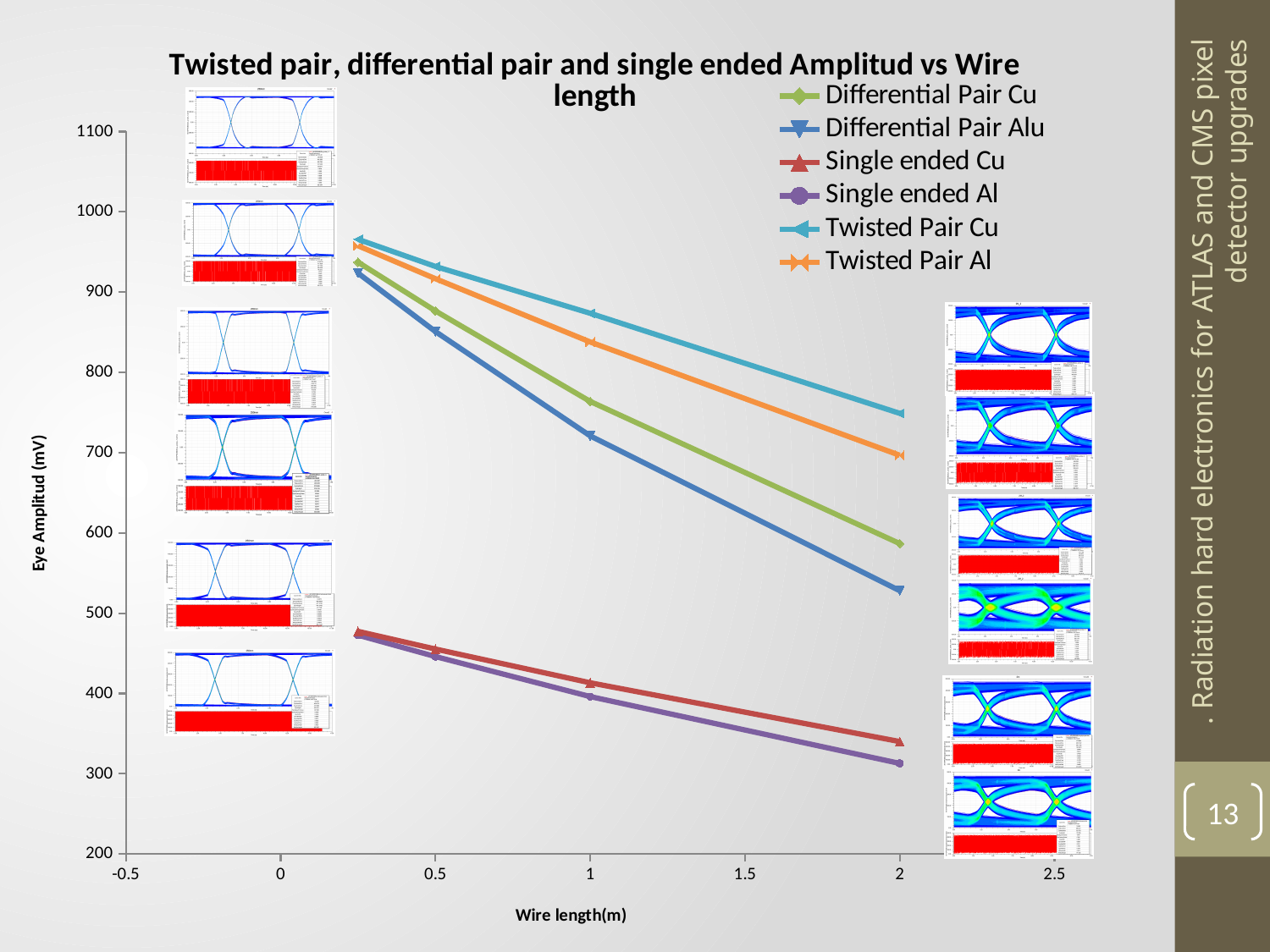
What kind of chart is shown on the slide? Line chart Which series has the highest eye amplitude at a wire length of 2 m? Twisted Pair Cu Does the eye amplitude for Differential Pair Cu rise or fall as wire length increases? Fall At a wire length of 2 m, which is larger: Differential Pair Cu or Single ended Cu? Differential Pair Cu Is the value for Differential Pair Alu at a wire length of 1 m greater or less than 800? less Is the value for Single ended Cu at a wire length of 2 m greater or less than 400? less How many series does the legend list? 6 What is the label of the x axis? Wire length(m) What is the label of the y axis? Eye Amplitud (mV) Is the value for Twisted Pair Cu at a wire length of 2 m greater or less than 700? greater Which series has the lowest eye amplitude at a wire length of 2 m? Single ended Al